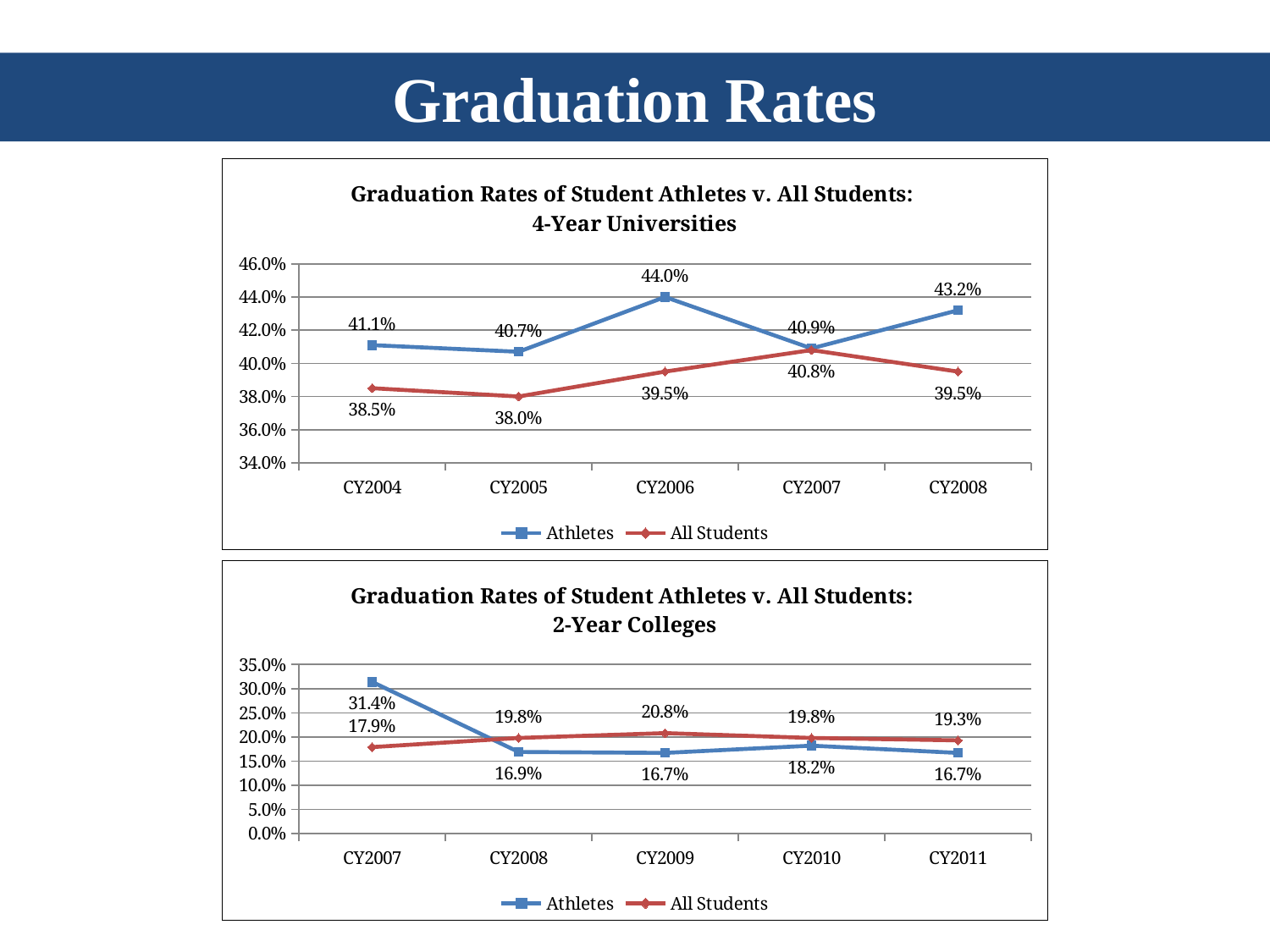
In the 4-Year Universities chart, how many series does the legend list? 2 What type of chart is the 2-Year Colleges chart? line chart In the 4-Year Universities chart, what is the graduation rate for Athletes in CY2006? 44.0% In the 2-Year Colleges chart, which is larger in CY2010: the Athletes rate or the All Students rate? All Students In the 4-Year Universities chart, in which year is the All Students graduation rate lowest? CY2005 In the 2-Year Colleges chart, what is the graduation rate for Athletes in CY2007? 31.4% In the 4-Year Universities chart, in which year is the Athletes graduation rate highest? CY2006 In the 2-Year Colleges chart, does the Athletes graduation rate rise or fall from CY2007 to CY2008? fall In the 2-Year Colleges chart, what is the graduation rate for All Students in CY2009? 20.8% In the 2-Year Colleges chart, how many years are shown on the x axis? 5 In the 4-Year Universities chart, what is the difference between the Athletes and All Students graduation rates in CY2008? 3.7% In the 4-Year Universities chart, what is the graduation rate for All Students in CY2005? 38.0%